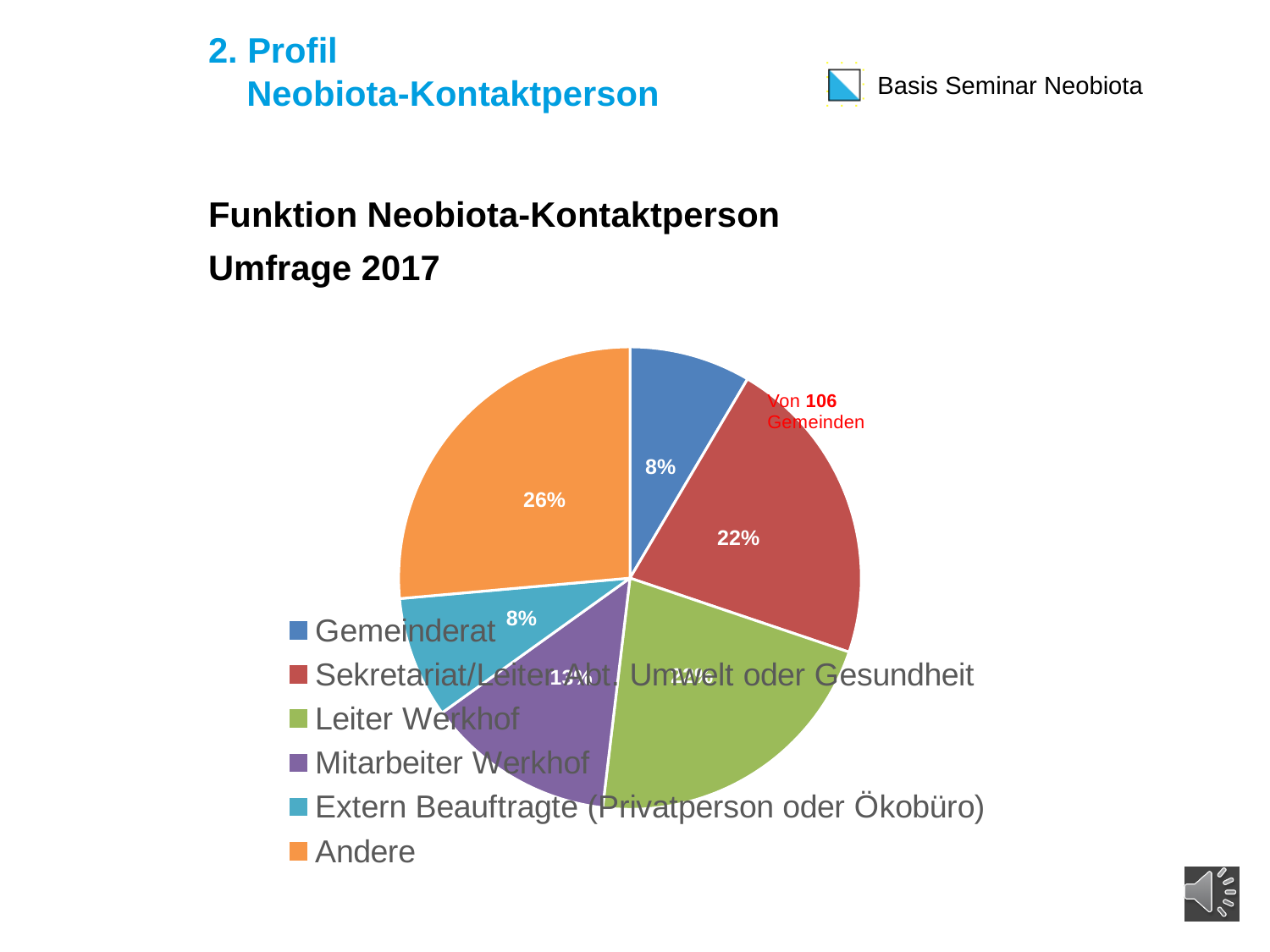
Which slice is larger, Andere or Gemeinderat? Andere What kind of chart is shown on the slide? pie chart What colour represents Andere in the pie chart legend? orange What share of the pie is labelled for Andere? 26% How many slices does the pie chart have? 6 According to the annotation on the chart, how many Gemeinden does the survey cover? 106 By how many percentage points is the Andere share larger than the Sekretariat/Leiter Abt. Umwelt oder Gesundheit share? 4 percentage points What share of the pie is labelled for Sekretariat/Leiter Abt. Umwelt oder Gesundheit? 22% What share of the pie is labelled for Gemeinderat? 8% Which slice is larger, Leiter Werkhof or Gemeinderat? Leiter Werkhof What share of the pie is labelled for Extern Beauftragte (Privatperson oder Ökobüro)? 8% Which slice is larger, Sekretariat/Leiter Abt. Umwelt oder Gesundheit or Extern Beauftragte (Privatperson oder Ökobüro)? Sekretariat/Leiter Abt. Umwelt oder Gesundheit